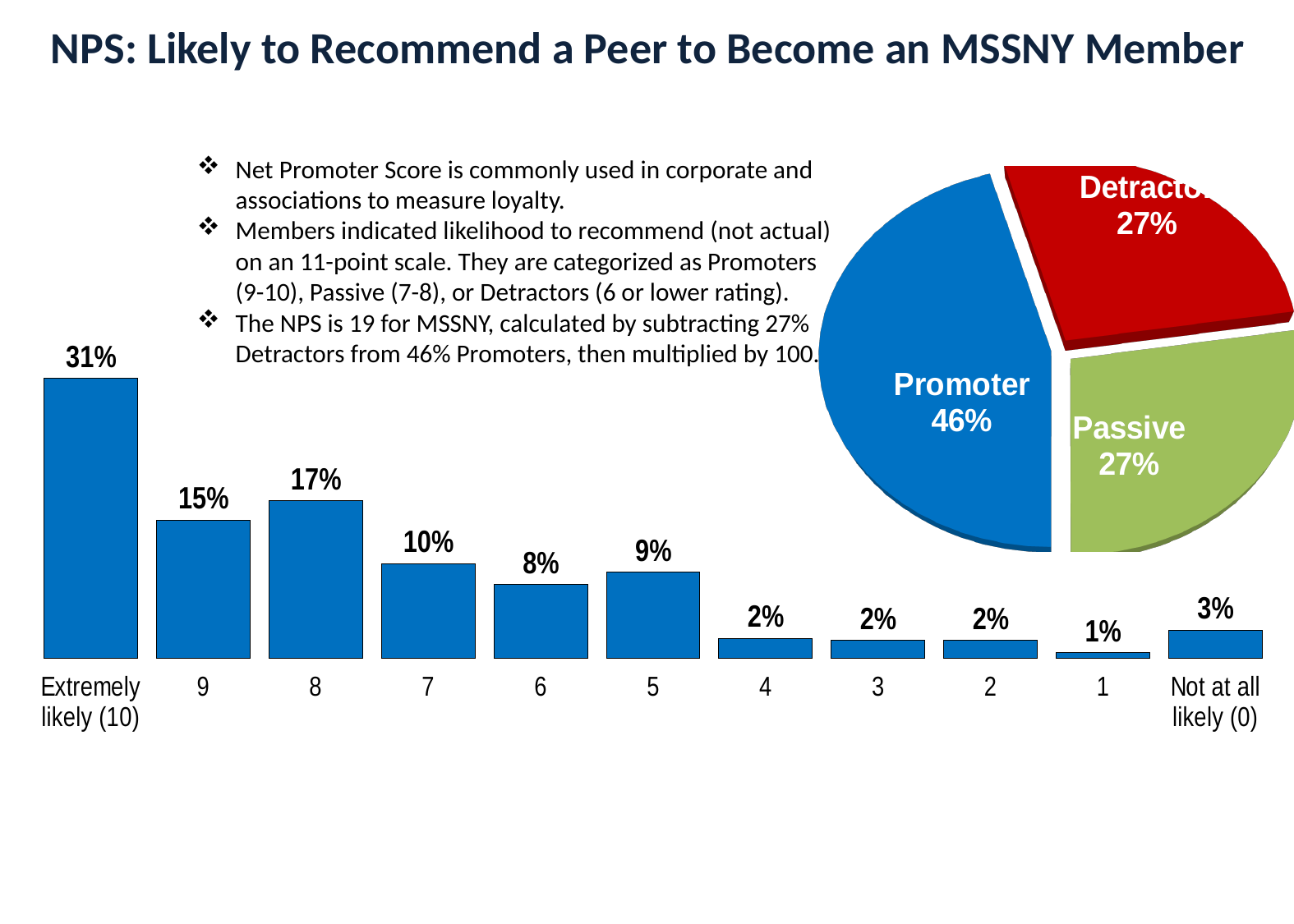
In the pie chart, what share is labelled for Promoter? 46% How many categories are shown in the bar chart? 11 In the bar chart, which category has the highest value? Extremely likely (10) In the pie chart, what share is labelled for Passive? 27% In the bar chart, what is the value for 'Not at all likely (0)'? 3% In the bar chart, what is the value for 'Extremely likely (10)'? 31% In the bar chart, what is the difference between the values for rating 8 and rating 9? 2% In the bar chart, which category has the lowest value? 1 What kind of chart is the chart in the lower part of the slide? bar chart In the bar chart, what is the value for rating 8? 17% In the bar chart, which is larger, the value for rating 7 or the value for rating 5? 7 What kind of chart is the chart in the upper right of the slide? pie chart